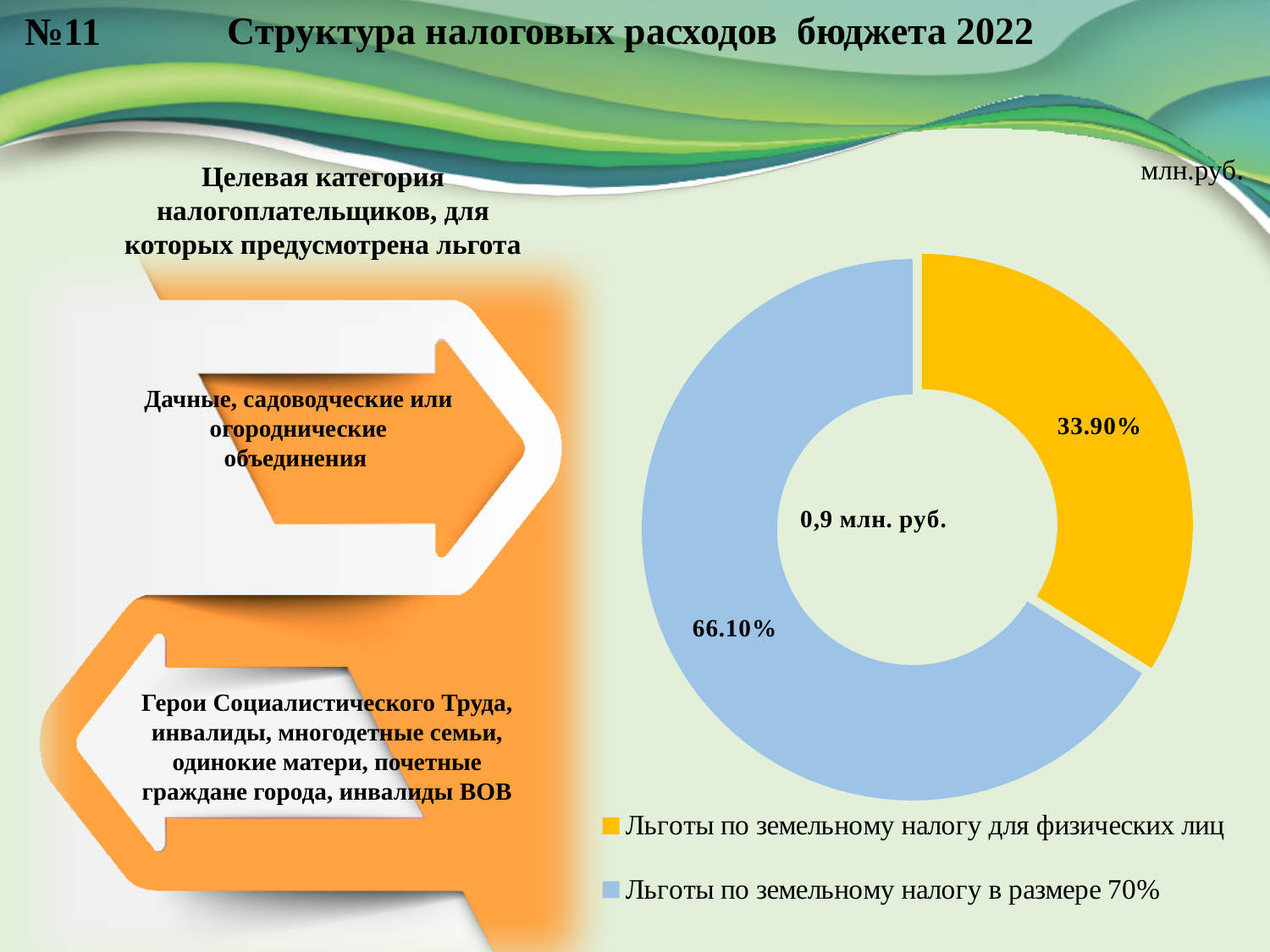
What is the difference in percentage points between the two slices of the chart? 32.20% What is the title of the slide containing the chart? Структура налоговых расходов бюджета 2022 Which is larger: the share for "Льготы по земельному налогу для физических лиц" or the share for "Льготы по земельному налогу в размере 70%"? Льготы по земельному налогу в размере 70% Which category has the smallest share in the chart? Льготы по земельному налогу для физических лиц What type of chart is shown on the slide? Doughnut (pie) chart Which category has the largest share in the chart? Льготы по земельному налогу в размере 70% What share of the chart is labelled for "Льготы по земельному налогу для физических лиц"? 33.90% How many entries does the chart legend list? 2 What share of the chart is labelled for "Льготы по земельному налогу в размере 70%"? 66.10% How many slices does the chart have? 2 What colour is the slice for "Льготы по земельному налогу в размере 70%"? Light blue What total value is printed in the centre of the doughnut chart? 0,9 млн. руб.